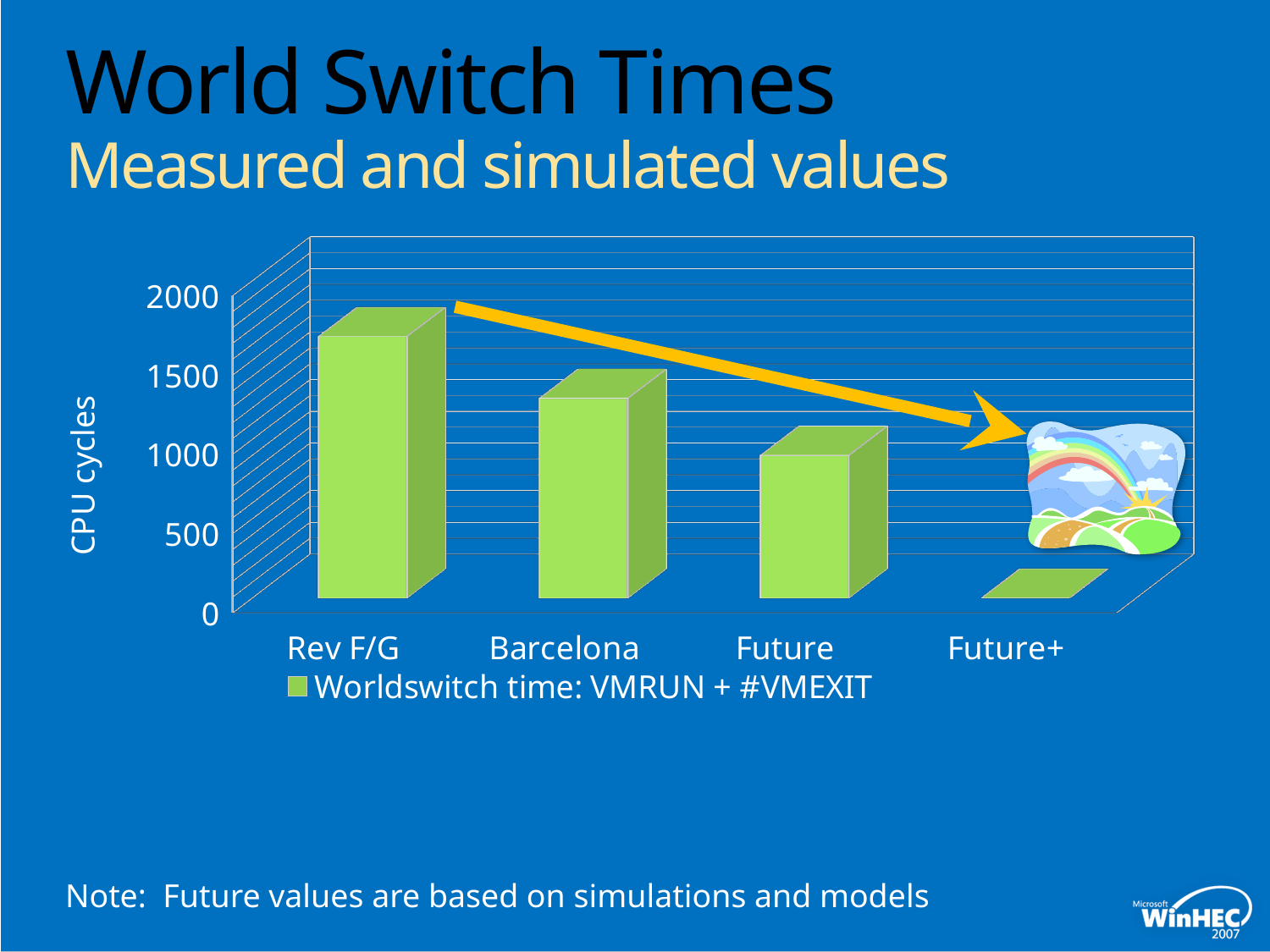
What kind of chart is shown on the slide? bar chart Is the value for Rev F/G greater or less than 1500 CPU cycles? greater Is the value for Barcelona greater or less than 1000 CPU cycles? greater Is the value for Future greater or less than 500 CPU cycles? greater What is the label on the vertical axis of the chart? CPU cycles Do the worldswitch times rise or fall from Rev F/G to Future+? fall Which category has the highest worldswitch time? Rev F/G How many series does the chart's legend list? 1 Which has a larger worldswitch time, Barcelona or Future? Barcelona Which category has the lowest worldswitch time? Future+ How many categories are shown on the x axis of the chart? 4 Which has a larger worldswitch time, Rev F/G or Barcelona? Rev F/G